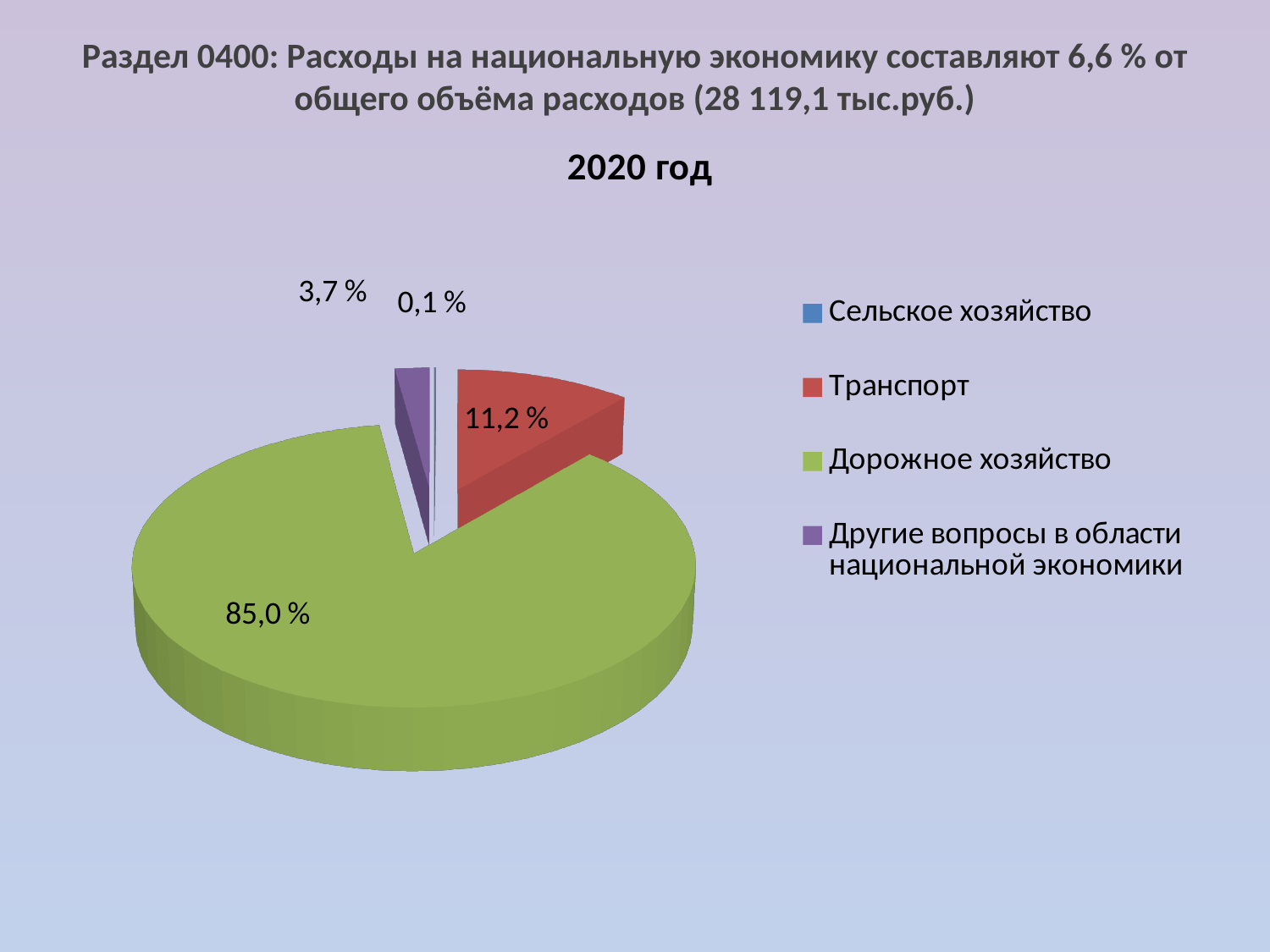
Which category has the smallest slice of the pie? Сельское хозяйство What share of the pie does Сельское хозяйство have? 0,1 % How many categories does the legend list? 4 What is the difference between the shares of Дорожное хозяйство and Транспорт? 73,8 % What year is shown in the chart title? 2020 год Which category has the largest slice of the pie? Дорожное хозяйство What colour is the slice for Транспорт? Red What share of the pie does Другие вопросы в области национальной экономики have? 3,7 % What share of the pie does Транспорт have? 11,2 % What kind of chart is shown on the slide? Pie chart Which is larger, the share of Транспорт or the share of Другие вопросы в области национальной экономики? Транспорт What share of the pie does Дорожное хозяйство have? 85,0 %